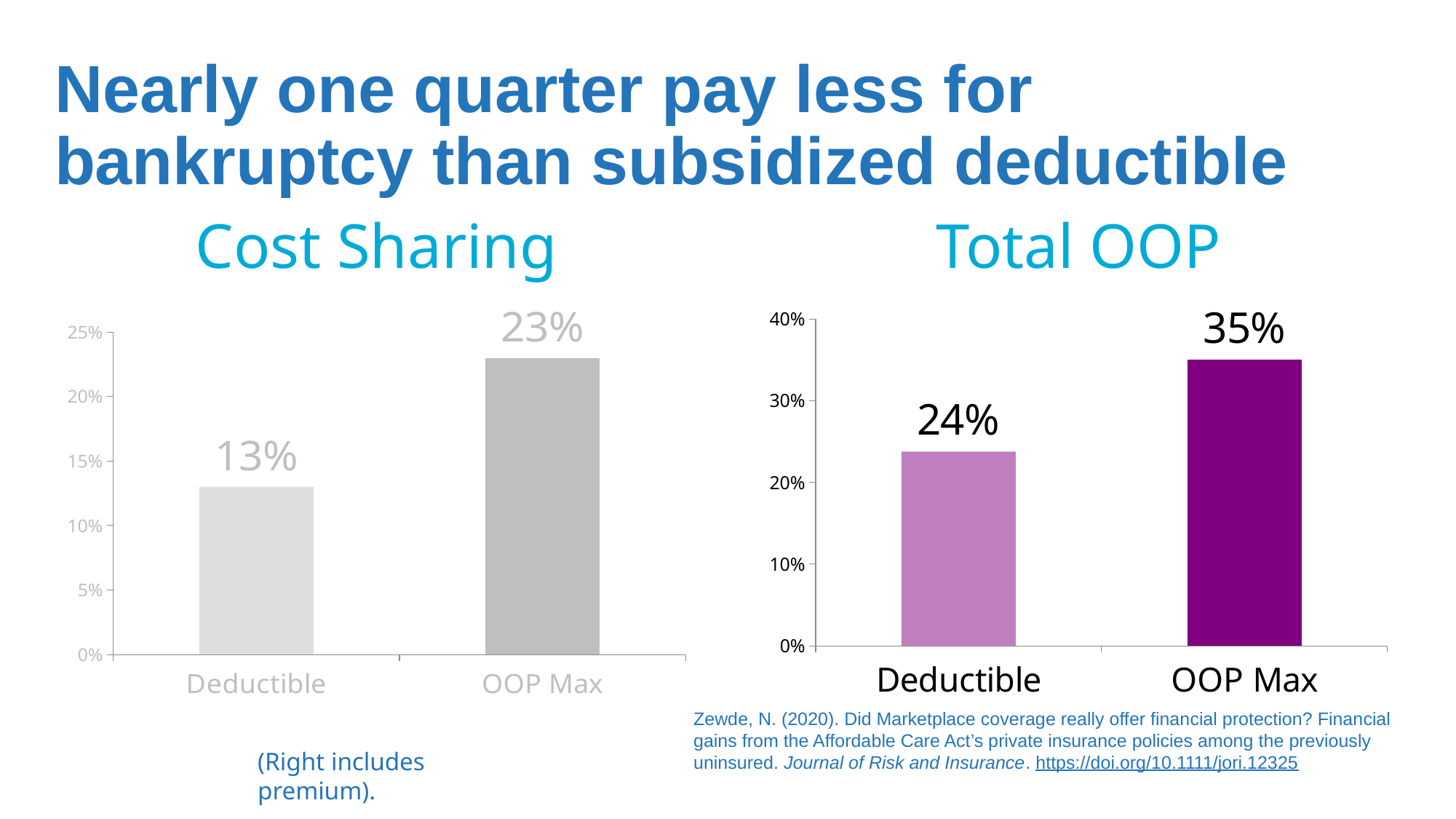
In the Total OOP chart, which category has the lowest value? Deductible In the Cost Sharing chart, what is the difference between the OOP Max and Deductible values? 10% In the Cost Sharing chart, which category has the highest value? OOP Max How many categories are shown in the Cost Sharing chart? 2 In the Total OOP chart, what is the value for OOP Max? 35% In the Cost Sharing chart, what is the value for Deductible? 13% What is the title of the chart on the right side of the slide? Total OOP In the Cost Sharing chart, what is the value for OOP Max? 23% In the Total OOP chart, is the value for Deductible greater or less than 20%? greater In the Total OOP chart, what is the value for Deductible? 24% What kind of chart is the Total OOP chart? Bar chart In the Total OOP chart, what is the difference between the OOP Max and Deductible values? 11%